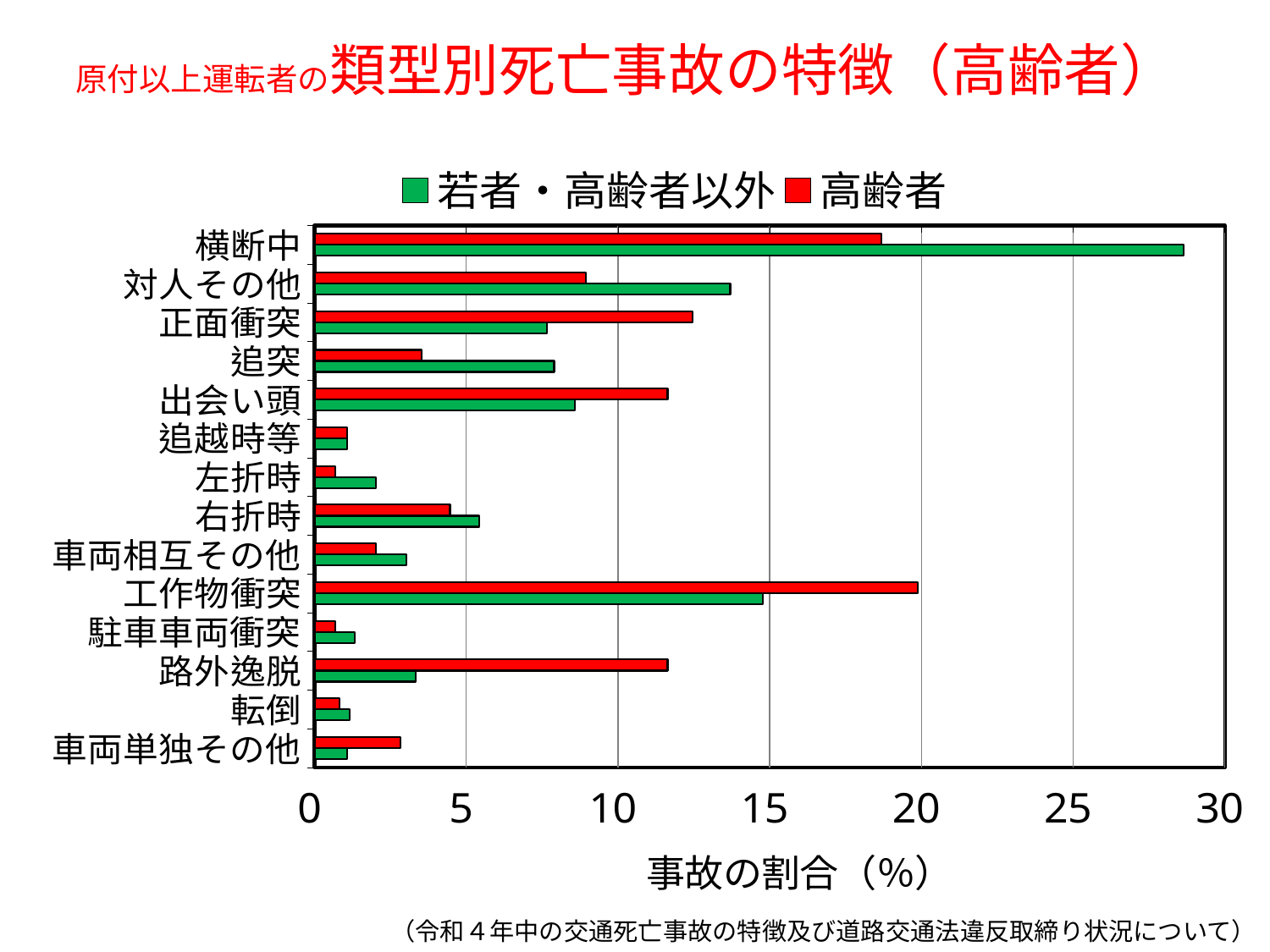
Which category has the highest value for the 若者・高齢者以外 series? 横断中 What colour represents the 高齢者 series in the legend? red What kind of chart is shown on the slide? bar chart How many accident-type categories are plotted on the y axis? 14 How many series does the legend list? 2 Is the 高齢者 value for 追突 greater or less than 5? less Which category has the highest value for the 高齢者 series? 工作物衝突 For 横断中, which series has the larger value, 若者・高齢者以外 or 高齢者? 若者・高齢者以外 Is the 若者・高齢者以外 value for 横断中 greater or less than 25? greater Is the 高齢者 value for 路外逸脱 greater or less than 10? greater For 路外逸脱, which series has the larger value, 若者・高齢者以外 or 高齢者? 高齢者